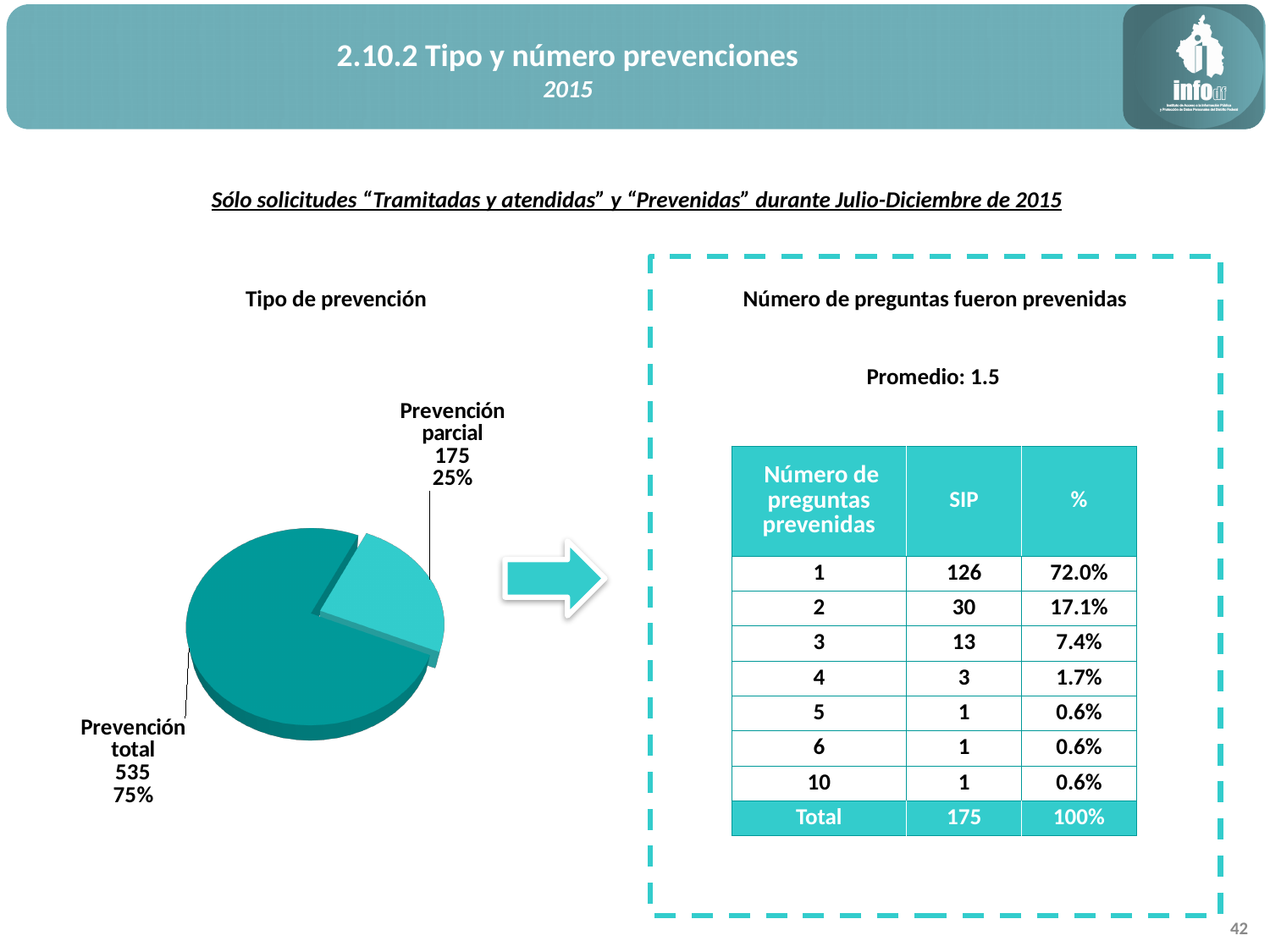
What is the title of the pie chart on the left of the slide? Tipo de prevención What is the total of the two values shown in the "Tipo de prevención" pie chart? 710 In the "Tipo de prevención" pie chart, what share of the pie does Prevención total represent? 75% In the "Tipo de prevención" pie chart, what is the difference between the values for Prevención total and Prevención parcial? 360 What type of chart is shown under the title "Tipo de prevención"? Pie chart In the "Tipo de prevención" pie chart, what is the value for Prevención parcial? 175 In the "Tipo de prevención" pie chart, which slice is the largest? Prevención total In the "Tipo de prevención" pie chart, which is larger: Prevención total or Prevención parcial? Prevención total How many slices does the "Tipo de prevención" pie chart have? 2 In the "Tipo de prevención" pie chart, which slice is the smallest? Prevención parcial In the "Tipo de prevención" pie chart, what share of the pie does Prevención parcial represent? 25% In the "Tipo de prevención" pie chart, what is the value for Prevención total? 535